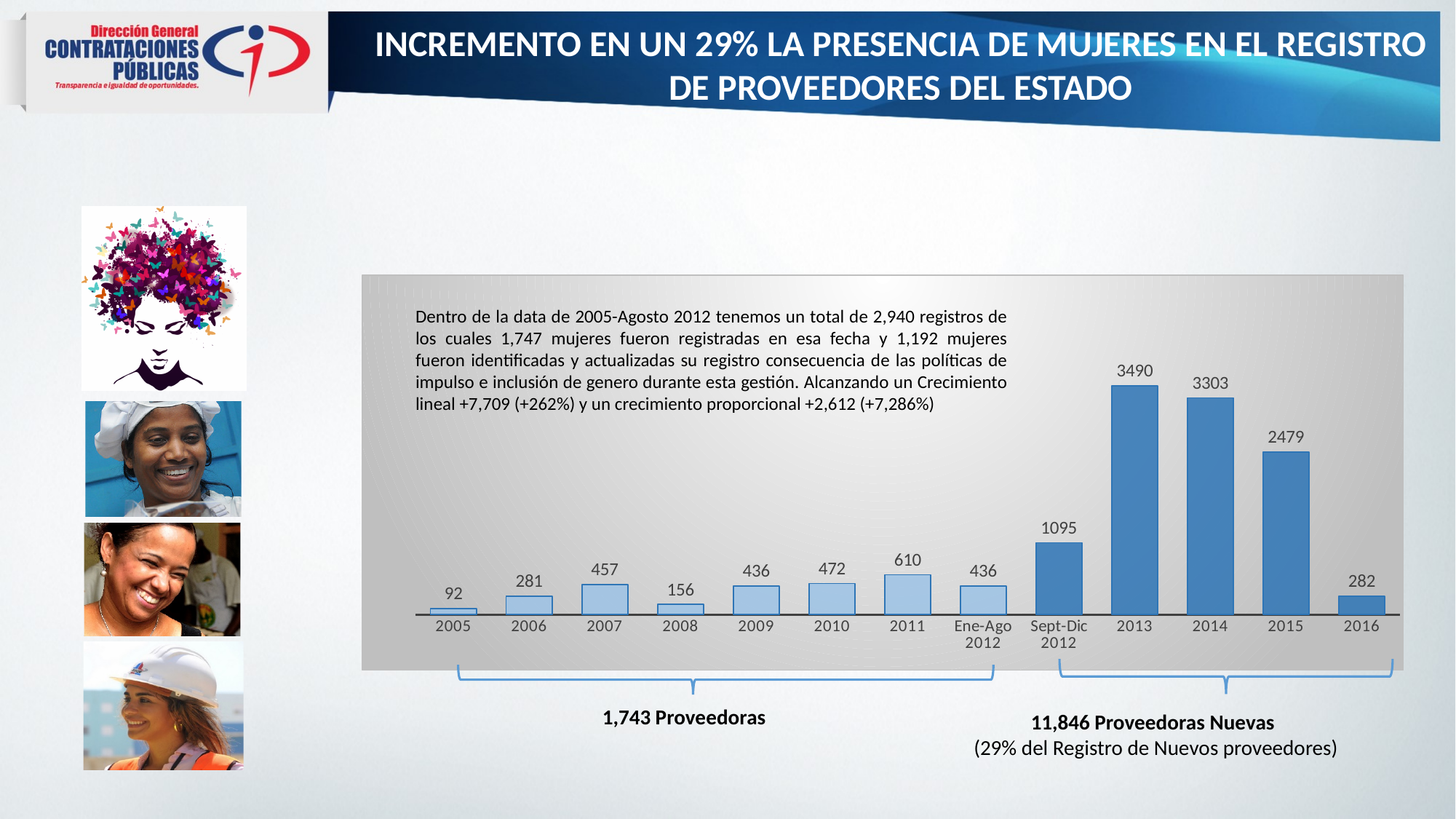
What is the value for 2008? 156 What is the difference between the values for 2011 and 2010? 138 How many categories are shown on the x axis? 13 Which category has the lowest value? 2005 Do the values rise or fall from 2013 to 2016? fall What is the difference between the values for 2013 and 2014? 187 What is the value for 2016? 282 Which is larger, the value for 2015 or the value for 2014? 2014 What is the value for Sept-Dic 2012? 1095 What is the value for 2013? 3490 Which category has the highest value? 2013 What kind of chart is shown on the slide? bar chart